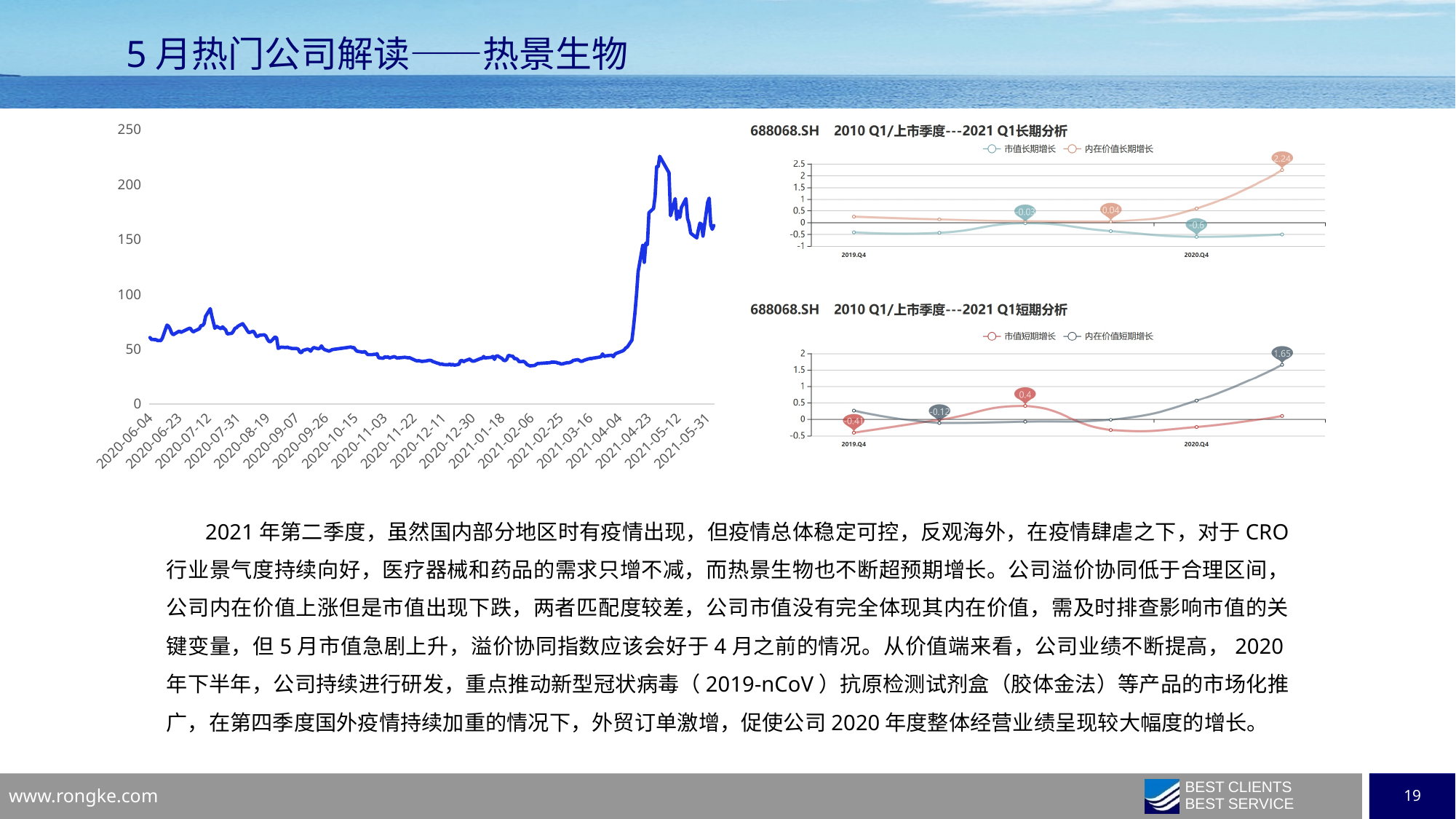
In the chart titled '688068.SH 2010 Q1/上市季度---2021 Q1短期分析', what is the labelled value for 市值短期增长 at 2019.Q4? -0.41 On the left line chart, is the value around 2021-01-18 greater or less than 50? less What kind of chart is the large chart on the left of the slide? line chart In the chart titled '688068.SH 2010 Q1/上市季度---2021 Q1长期分析', what is the labelled value for 市值长期增长 near 2020.Q4? -0.6 In the chart titled '688068.SH 2010 Q1/上市季度---2021 Q1短期分析', what is the highest labelled value for 内在价值短期增长? 1.65 On the left line chart, what is the highest value shown on the y axis? 250 On the left line chart, is the peak value reached in late April 2021 greater or less than 200? greater In the chart titled '688068.SH 2010 Q1/上市季度---2021 Q1长期分析', what is the highest labelled value for 内在价值长期增长? 2.24 In the chart titled '688068.SH 2010 Q1/上市季度---2021 Q1长期分析', how many series does the legend list? 2 On the left line chart, is the value at the end of the series (2021-05-31) greater or less than 150? greater In the chart titled '688068.SH 2010 Q1/上市季度---2021 Q1长期分析', what is the difference between the labelled values 2.24 and 0.04 for 内在价值长期增长? 2.2 On the left line chart, is the value at 2021-05-31 higher or lower than the value at 2020-06-04? higher